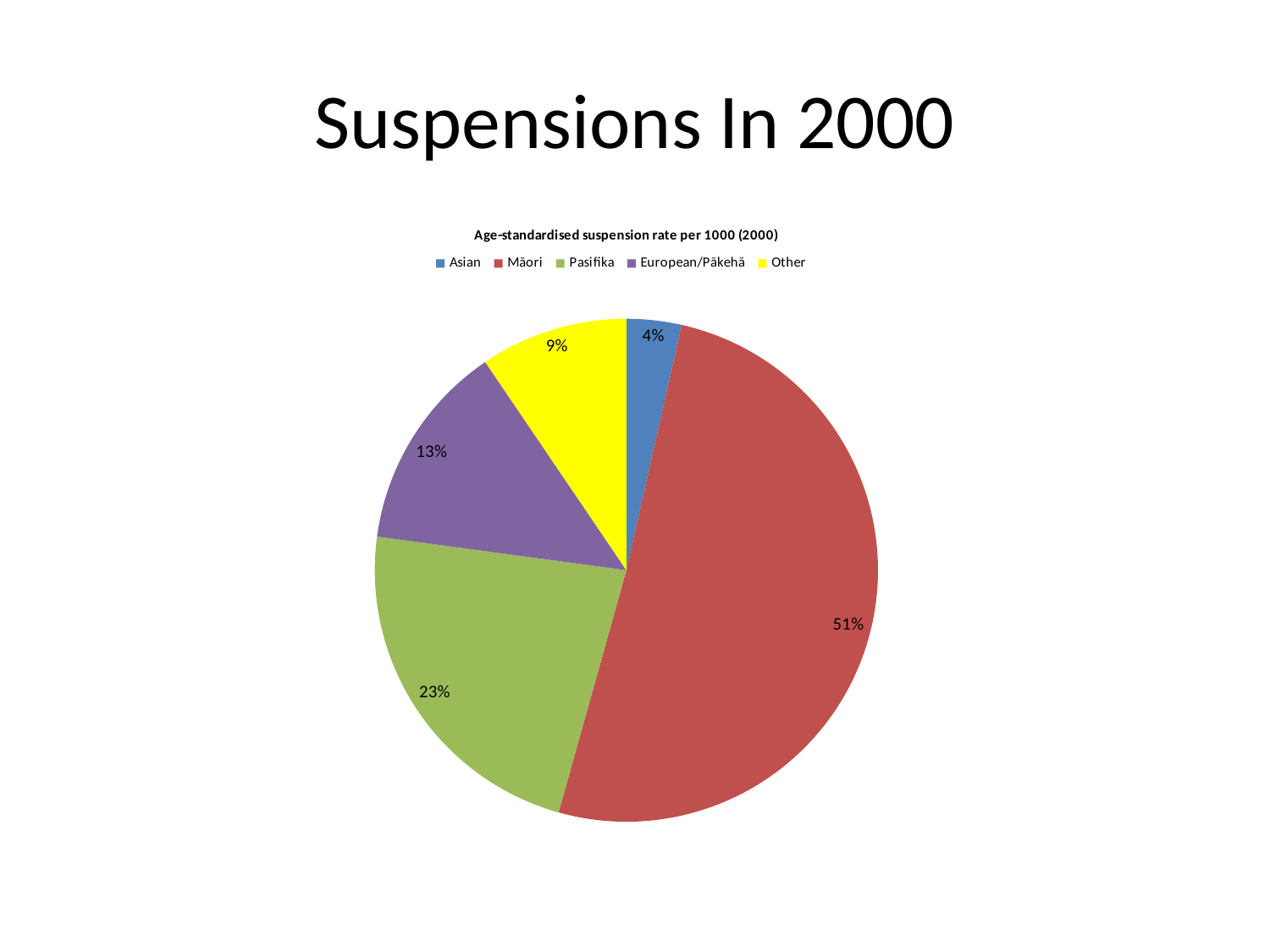
What type of chart is shown on the slide? pie chart What is the title of the chart? Age-standardised suspension rate per 1000 (2000) Which category has the smallest slice? Asian What share of the pie does Asian represent? 4% What share of the pie does Other represent? 9% What is the difference in percentage points between the Māori and Pasifika slices? 28 How many categories does the legend list? 5 Which slice is larger, European/Pākehā or Other? European/Pākehā What share of the pie does European/Pākehā represent? 13% Which category has the largest slice? Māori